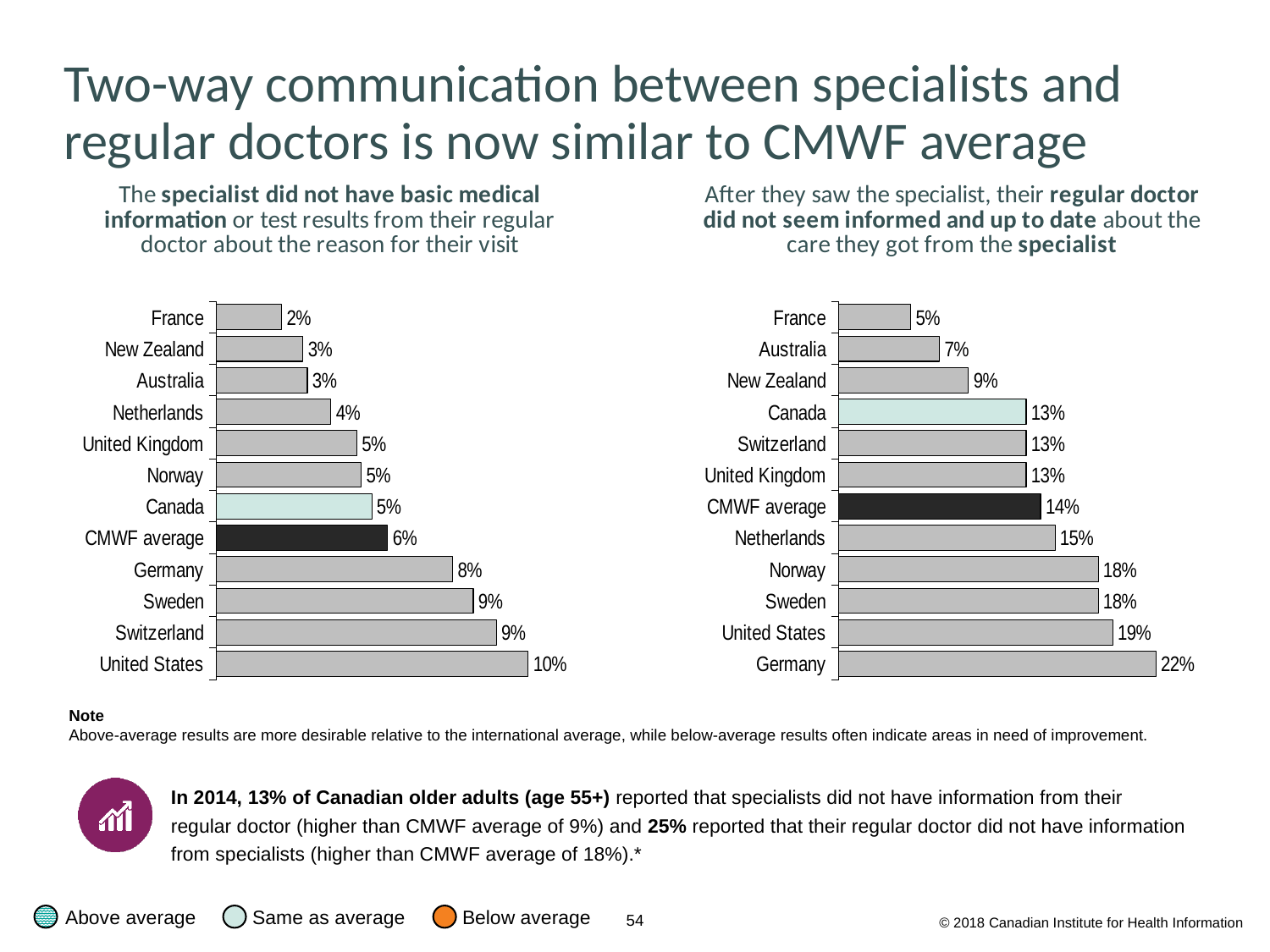
In the left chart, which country has the lowest value? France In the right chart, what is the value for Germany? 22% In the left chart, how many bars are shown? 12 In the right chart, what is the difference between Germany and the CMWF average? 8% In the left chart, what is the value for Canada? 5% In the left chart, what is the difference between the United States and France? 8% In the right chart, what is the value for Canada? 13% In the left chart, what is the value for the CMWF average? 6% In the right chart, which country has the lowest value? France What type of chart is the left chart? Bar chart In the left chart, which country has the highest value? United States In the right chart, which is larger, the value for Norway or the value for Australia? Norway